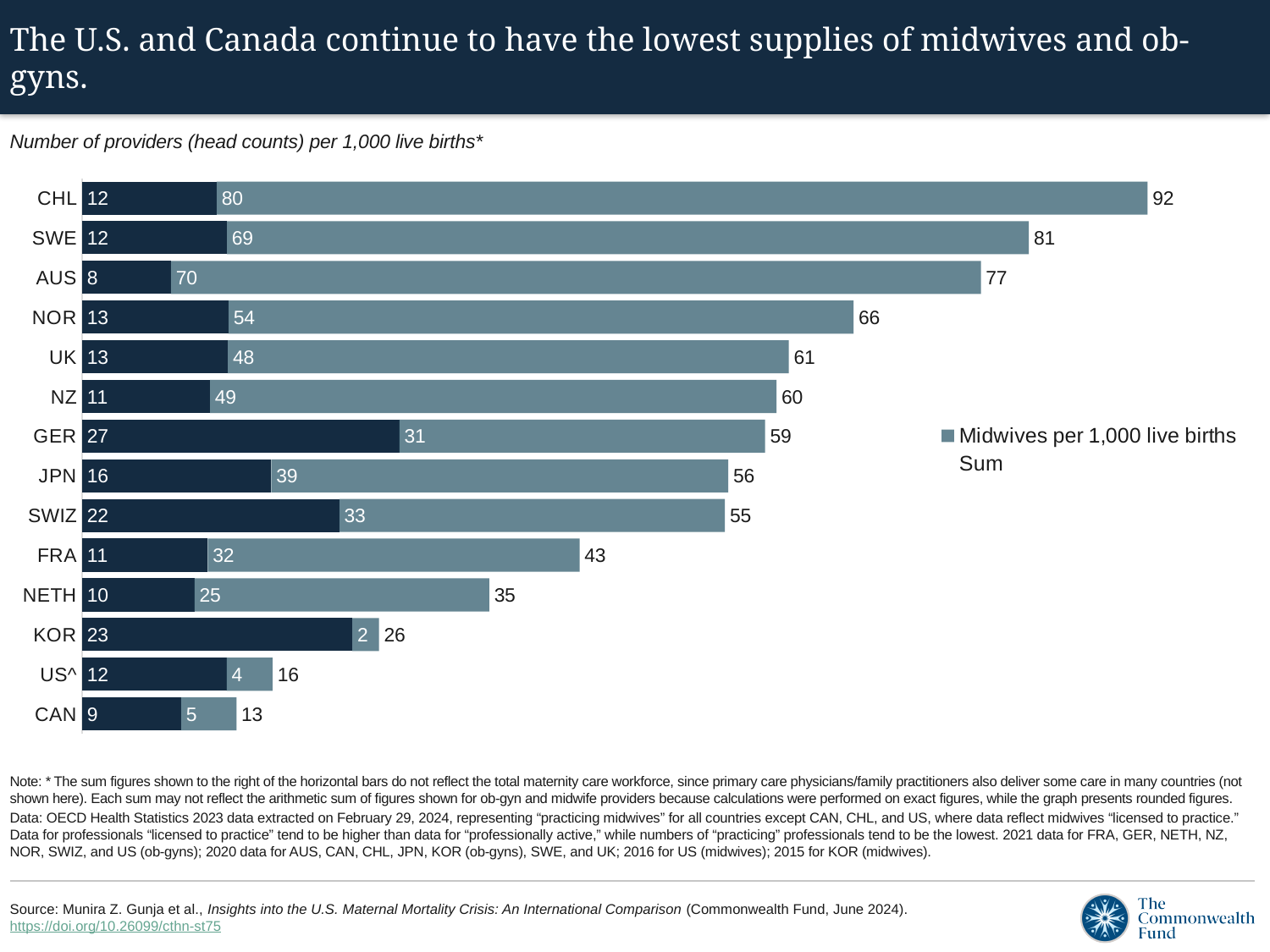
How many countries are shown in the chart? 14 What is the subtitle shown above the chart? Number of providers (head counts) per 1,000 live births* Which country has the lowest Sum value? CAN What is the difference between the Midwives per 1,000 live births values for CHL and SWE? 11 What is the Sum value shown for NOR? 66 What is the Sum value for the US^ bar? 16 What is the value for Midwives per 1,000 live births for CHL? 80 Which country has the highest Sum value? CHL Which has a larger Midwives per 1,000 live births value, JPN or SWIZ? JPN What is the value of the dark blue segment for GER? 27 Which country has the lowest value for Midwives per 1,000 live births? KOR What kind of chart is shown on the slide? Stacked bar chart